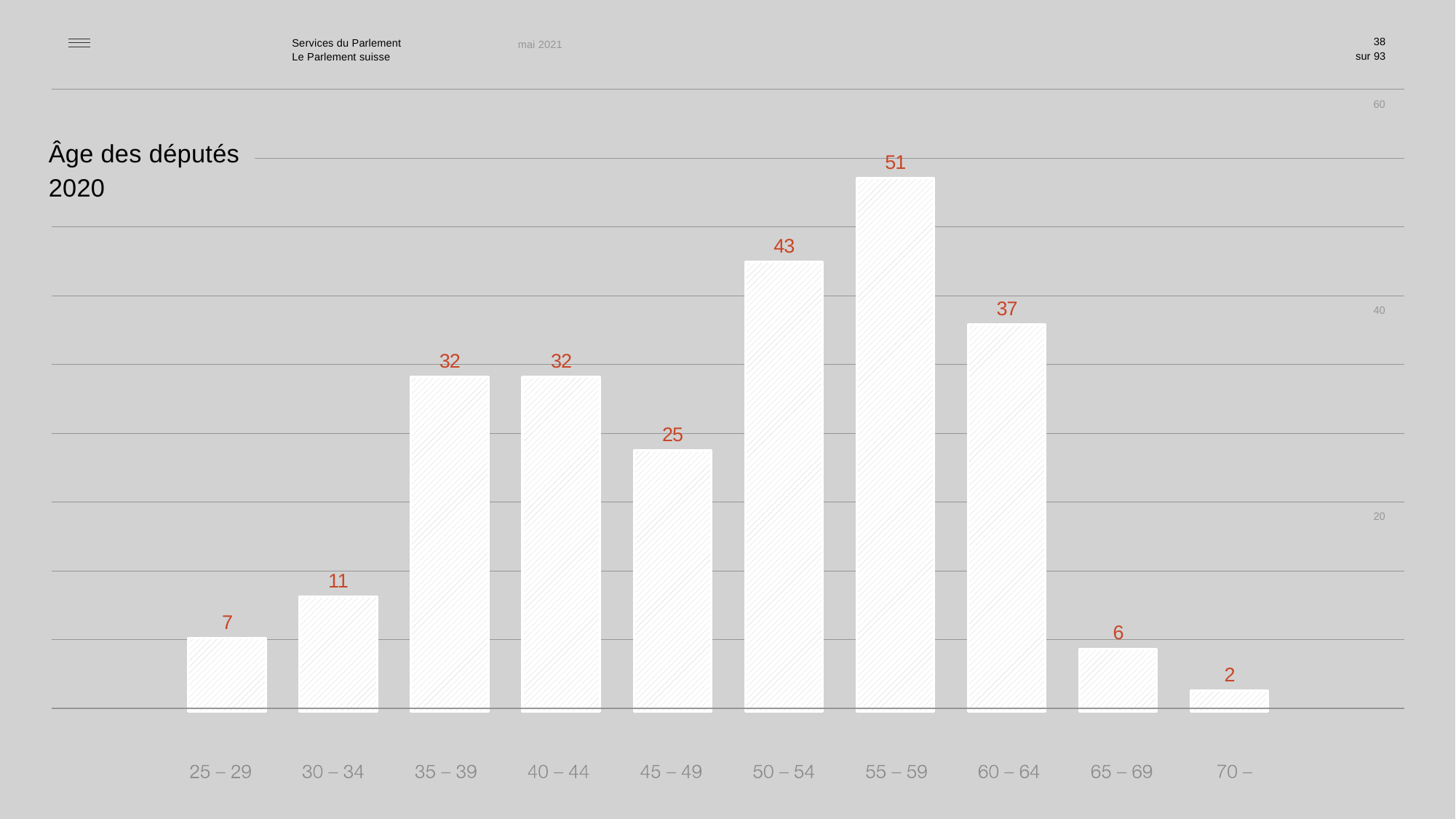
Which is larger, the value for 50 – 54 or the value for 60 – 64? 50 – 54 Which age group has the lowest value? 70 – What is the title of the chart? Âge des députés 2020 What is the difference between the values for 55 – 59 and 50 – 54? 8 What kind of chart is shown on the slide? Bar chart What is the value for the 55 – 59 age group? 51 How many age groups are shown on the chart? 10 What is the value for the 45 – 49 age group? 25 What is the value for the 25 – 29 age group? 7 Which age group has the highest value? 55 – 59 Is the value for 55 – 59 greater or less than 40? greater What is the difference between the values for 60 – 64 and 30 – 34? 26